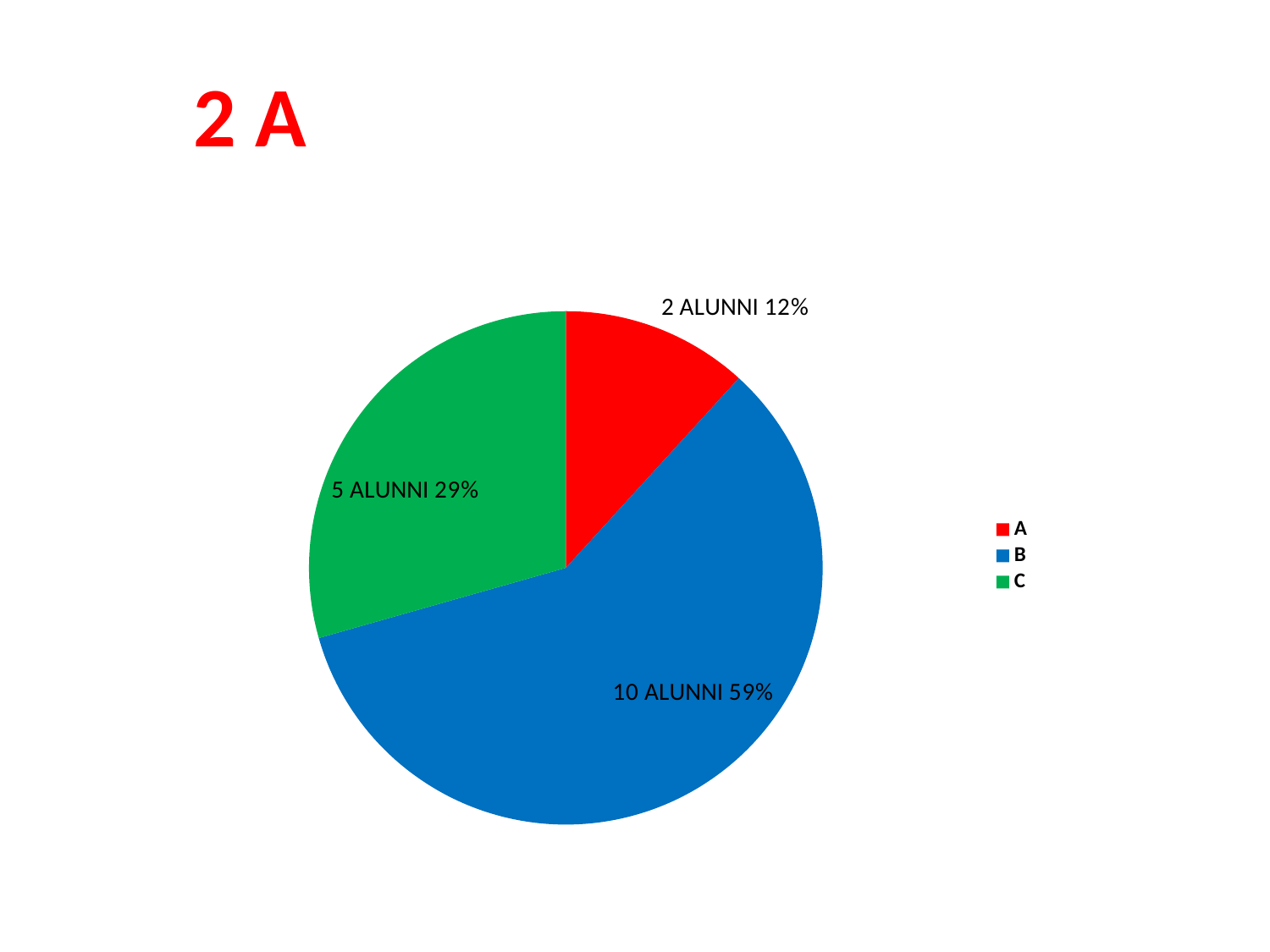
What percentage share does slice B have? 59% How many slices does the pie chart have? 3 How many alunni are in category C? 5 ALUNNI Which category has the smallest slice? A What kind of chart is shown on the slide? pie chart Which colour represents category C in the legend? green What is the difference in alunni between category B and category C? 5 How many entries does the legend list? 3 What percentage share does slice C have? 29% Which category has the largest slice? B How many alunni are in category B? 10 ALUNNI What percentage share does slice A have? 12%